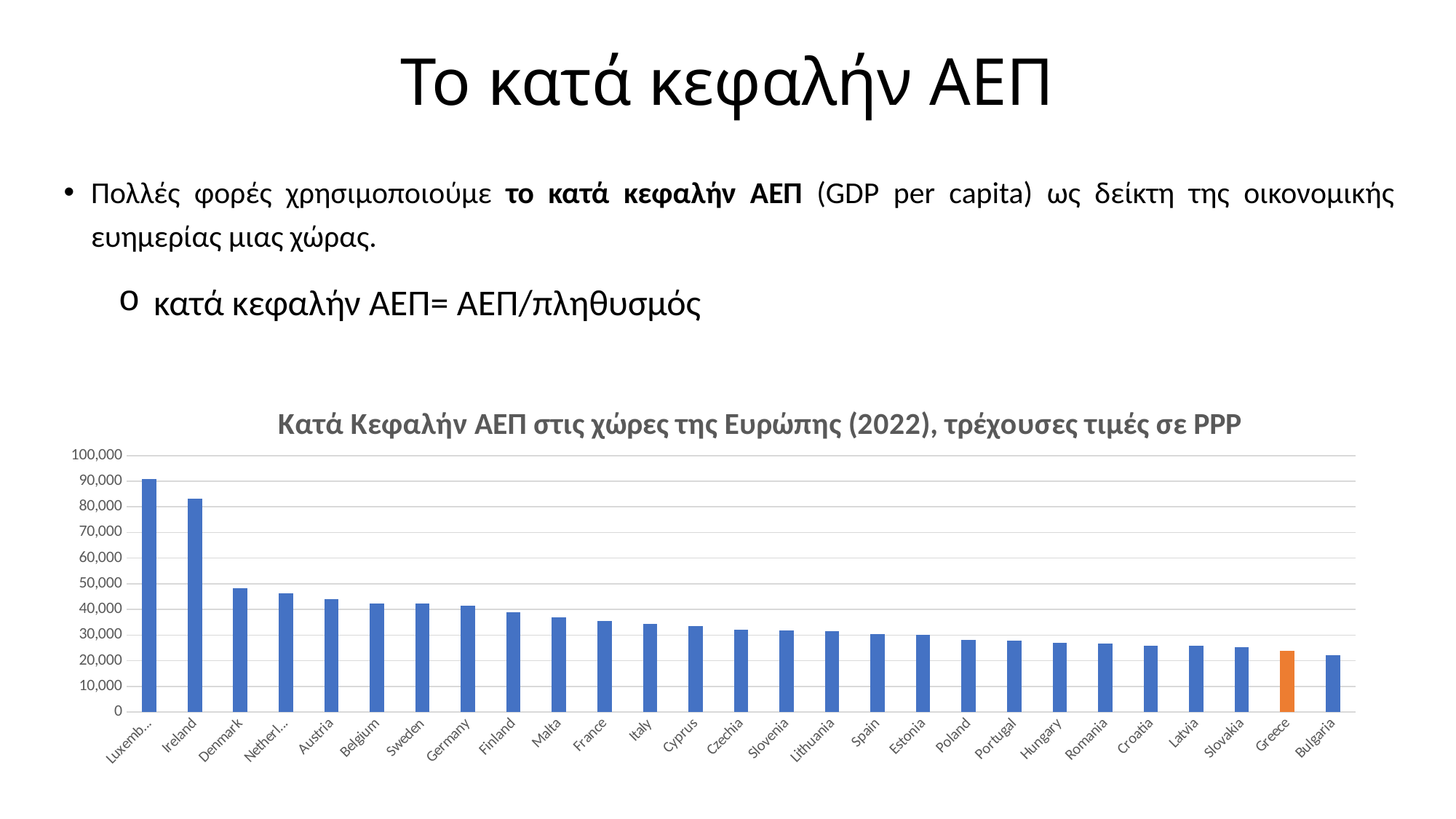
What kind of chart is shown on the slide? bar chart Is the value for Ireland greater or less than 70,000? greater How many countries are shown on the x axis of the chart? 27 Is the value for Denmark greater or less than 50,000? less Which country has the lowest GDP per capita in the chart? Bulgaria Do the values rise or fall from left to right along the x axis? fall Is the value for Greece greater or less than 20,000? greater Which country's bar is coloured orange instead of blue? Greece Which has a higher value, Ireland or Denmark? Ireland